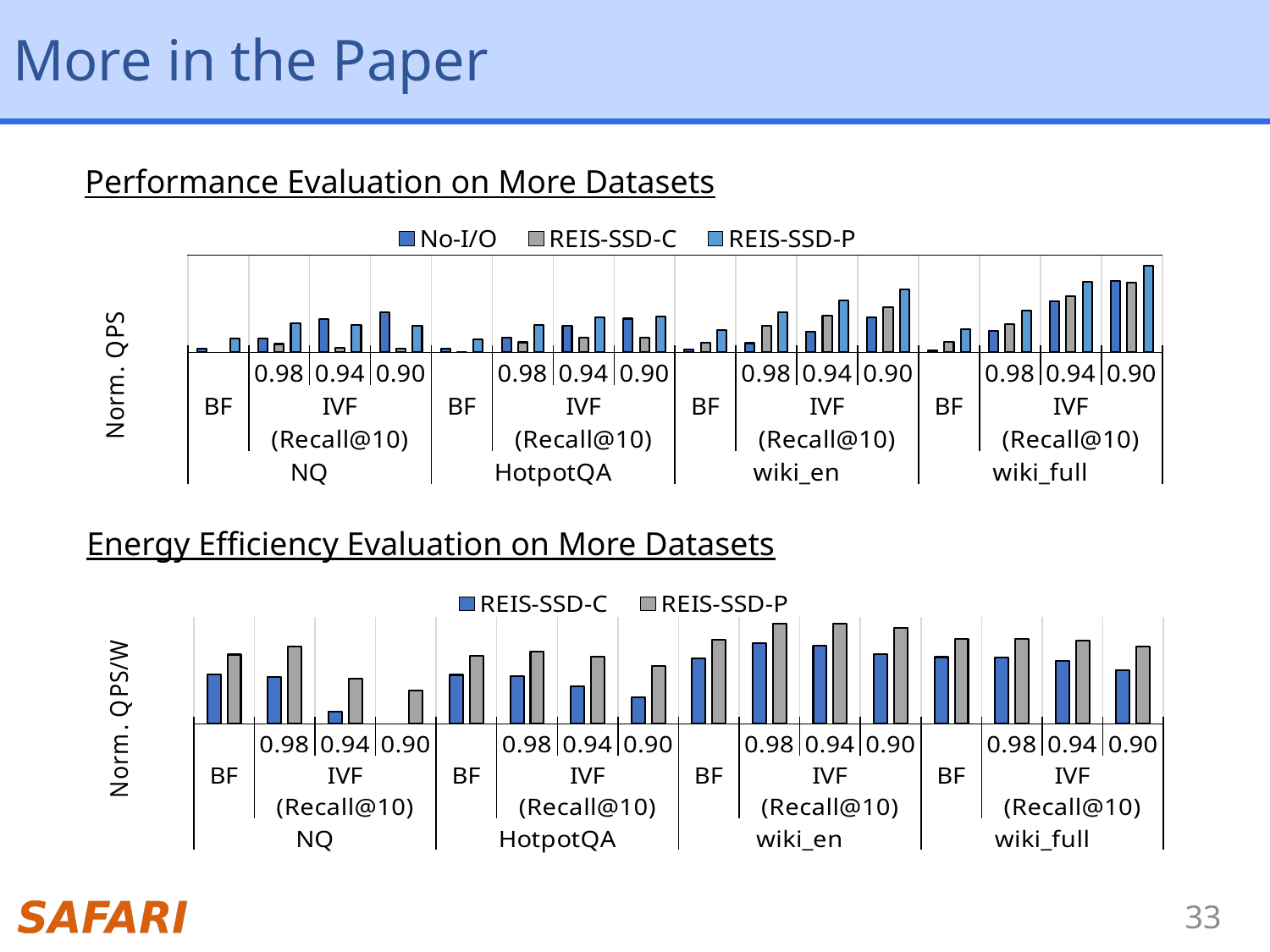
How many series does the legend of the Energy Efficiency Evaluation on More Datasets chart list? 2 What kind of chart is the Performance Evaluation on More Datasets chart? bar chart How many series does the legend of the Performance Evaluation on More Datasets chart list? 3 In the Performance Evaluation on More Datasets chart, which series are listed in the legend? No-I/O, REIS-SSD-C, REIS-SSD-P In the Performance Evaluation on More Datasets chart, which dataset contains the tallest bar overall? wiki_full How many datasets are shown along the x axis of the Performance Evaluation on More Datasets chart? 4 In the Performance Evaluation on More Datasets chart, for wiki_full IVF at Recall@10 of 0.90, which series has the tallest bar? REIS-SSD-P In the Energy Efficiency Evaluation on More Datasets chart, for NQ BF, which is larger: REIS-SSD-C or REIS-SSD-P? REIS-SSD-P In the Performance Evaluation on More Datasets chart, for NQ BF, which is larger: No-I/O or REIS-SSD-P? REIS-SSD-P What is the y-axis label of the Energy Efficiency Evaluation on More Datasets chart? Norm. QPS/W In the Energy Efficiency Evaluation on More Datasets chart, for wiki_en IVF at Recall@10 of 0.98, which is larger: REIS-SSD-C or REIS-SSD-P? REIS-SSD-P In the Performance Evaluation on More Datasets chart, does the REIS-SSD-P value for wiki_full rise or fall from BF to IVF at 0.90? rise